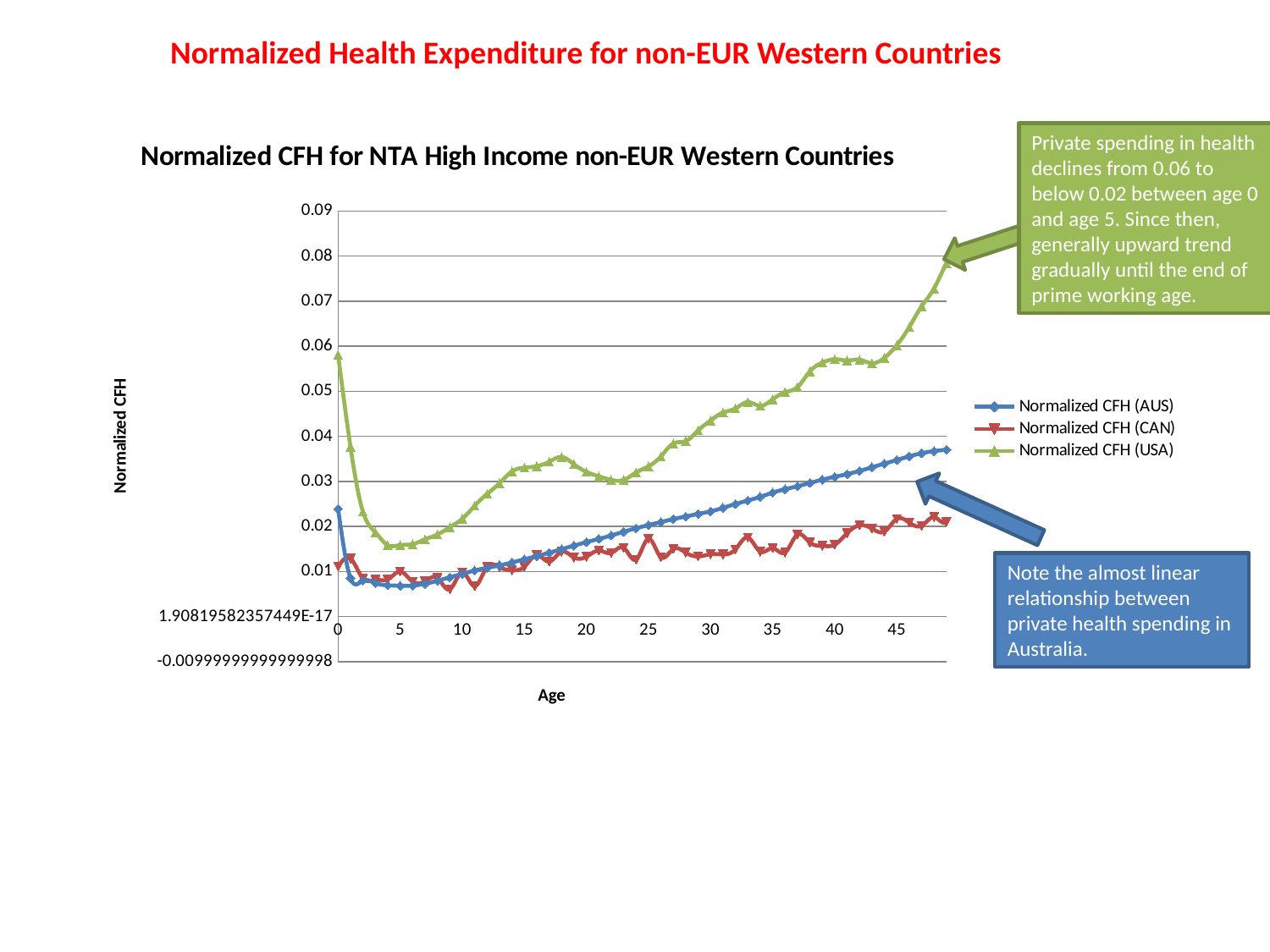
Which series has the lowest value at age 30? Normalized CFH (CAN) Is the value for Normalized CFH (USA) at the right end of the chart (around age 49) greater or less than 0.07? greater Does the Normalized CFH (AUS) series rise or fall between age 10 and age 45? rise How many series does the chart legend list? 3 What is the label of the x axis of the chart? Age What kind of chart is shown on the slide? line chart Is the value for Normalized CFH (AUS) at age 45 greater or less than 0.03? greater What is the title of the chart? Normalized CFH for NTA High Income non-EUR Western Countries Which series has the highest value at age 40? Normalized CFH (USA) At age 30, which is larger: Normalized CFH (AUS) or Normalized CFH (CAN)? Normalized CFH (AUS) Is the value for Normalized CFH (USA) at age 5 greater or less than 0.02? less